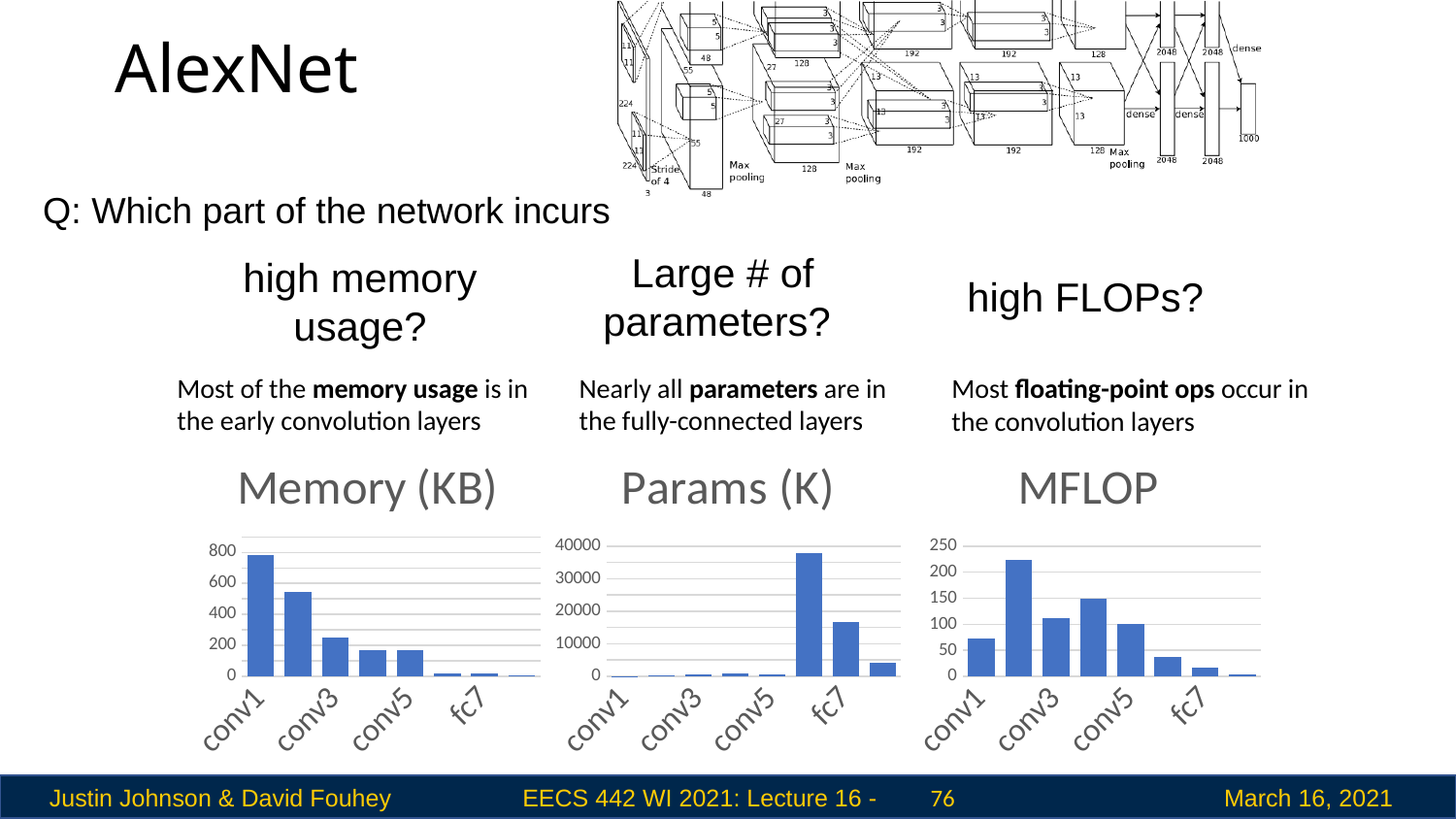
In the MFLOP chart, which is larger, the value for conv5 or the value for fc7? conv5 How many bar charts are shown on the slide? 3 In the Memory (KB) chart, is the value for conv1 greater or less than 600? greater In the Params (K) chart, is the value for conv1 greater or less than 10000? less In the Memory (KB) chart, which layer has the highest memory usage? conv1 In the MFLOP chart, is the value for conv1 greater or less than 100? less In the Params (K) chart, which has more parameters, conv3 or fc7? fc7 How many bars are plotted in the Params (K) chart? 8 In the Memory (KB) chart, do the values generally rise or fall from conv1 to fc7? fall What kind of chart is the Memory (KB) chart? bar chart